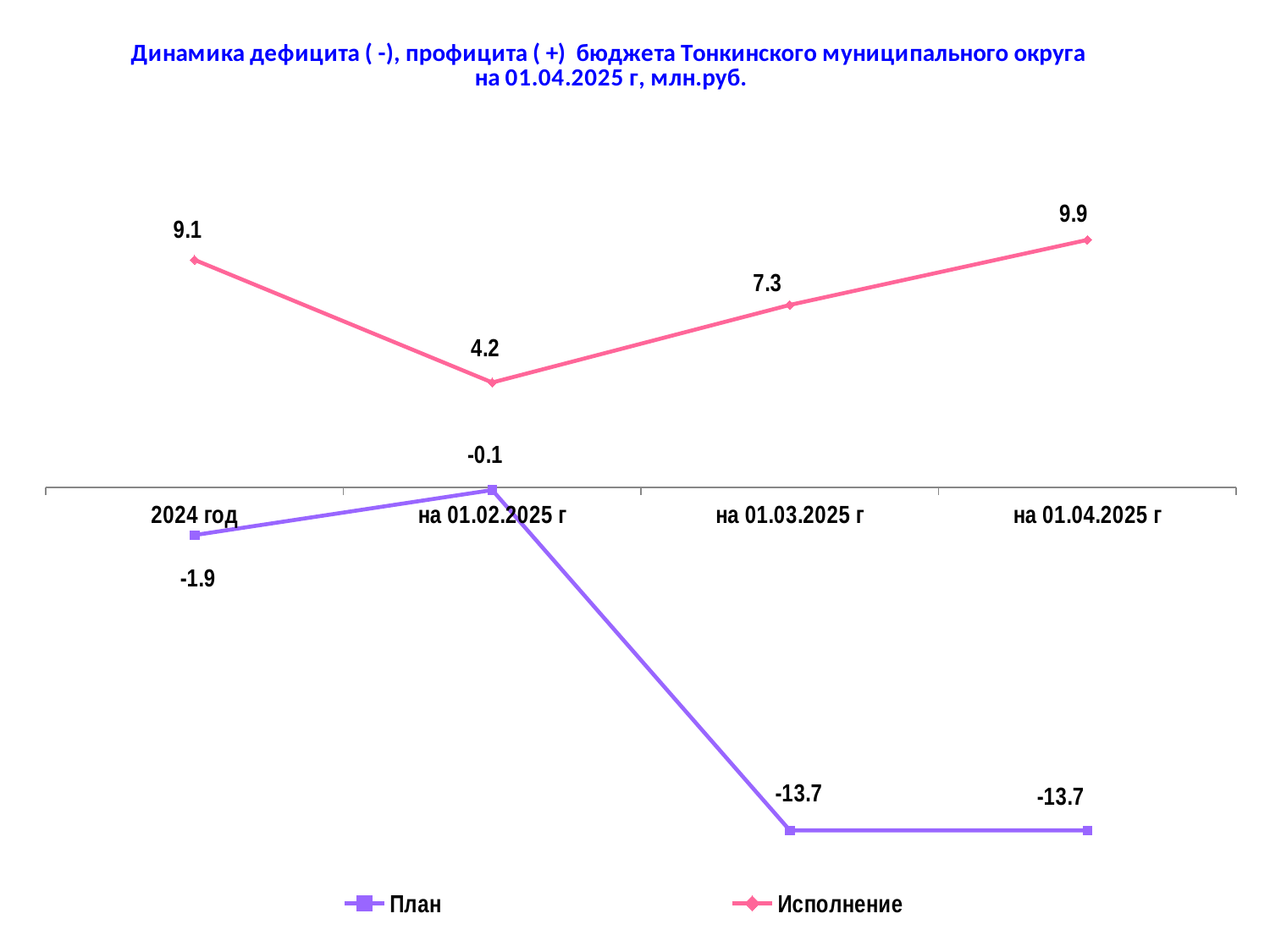
What kind of chart is shown? line chart At which point is the Исполнение series lowest? на 01.02.2025 г How many points are plotted along the x axis? 4 Does the Исполнение series rise or fall from на 01.02.2025 г to на 01.04.2025 г? rise At which point is the Исполнение series highest? на 01.04.2025 г What is the value of Исполнение for 2024 год? 9.1 What is the difference between Исполнение and План for на 01.04.2025 г? 23.6 What is the value of Исполнение for на 01.02.2025 г? 4.2 How many series does the legend list? 2 What is the value of План for 2024 год? -1.9 Which is larger for на 01.02.2025 г: План or Исполнение? Исполнение What is the value of План for на 01.03.2025 г? -13.7